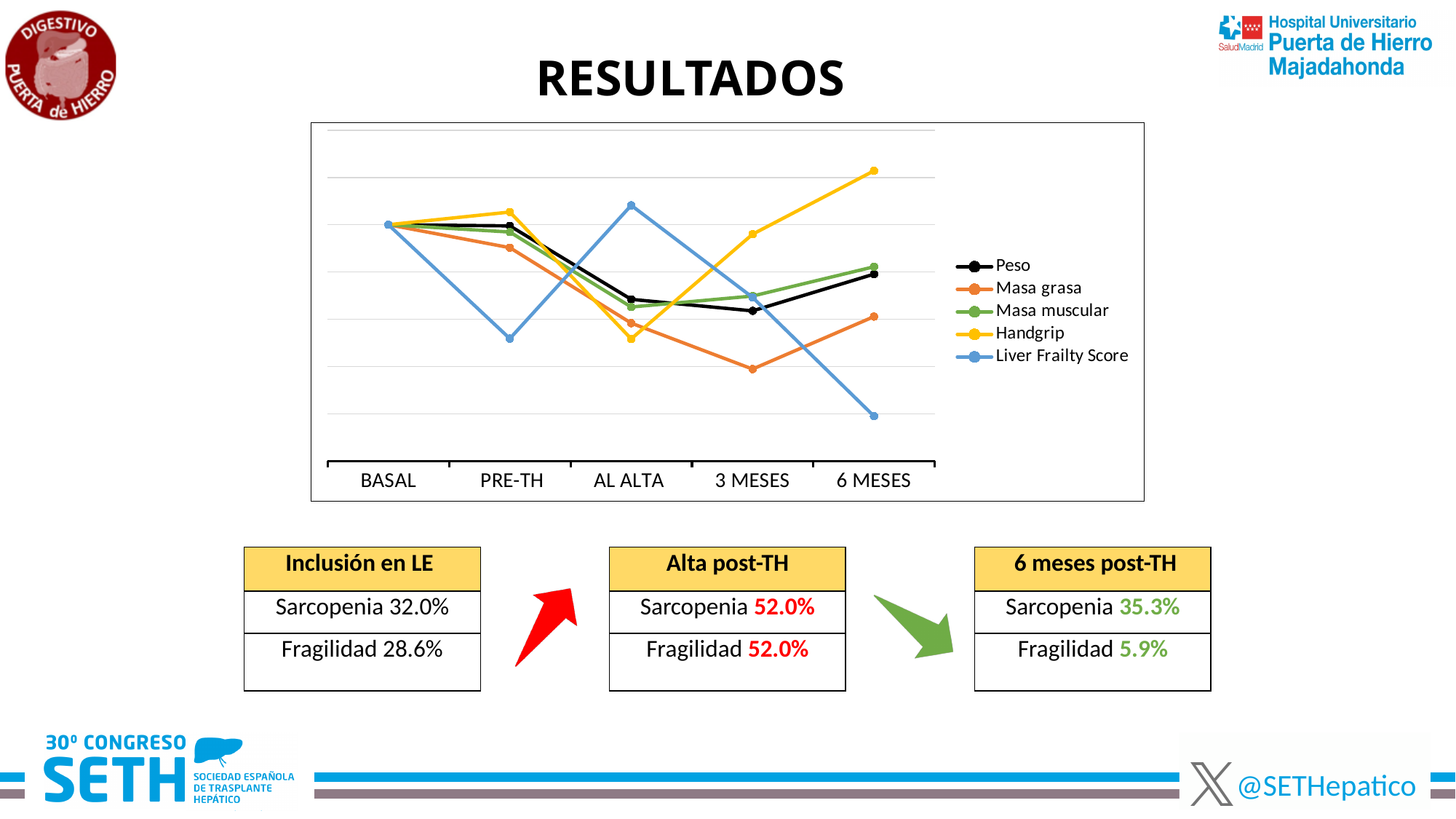
What is the label of the first category on the x axis of the chart? BASAL At 6 MESES, which is higher: Handgrip or Masa grasa? Handgrip Which series is lowest at 3 MESES? Masa grasa What kind of chart is shown on the slide? line chart Which series is highest at AL ALTA? Liver Frailty Score Which series is highest at 6 MESES? Handgrip How many time points are shown along the x axis of the chart? 5 Which series is lowest at PRE-TH? Liver Frailty Score Which series is lowest at 6 MESES? Liver Frailty Score Does the Handgrip series rise or fall between AL ALTA and 6 MESES? rise How many series does the chart's legend list? 5 Does the Liver Frailty Score series rise or fall between AL ALTA and 6 MESES? fall